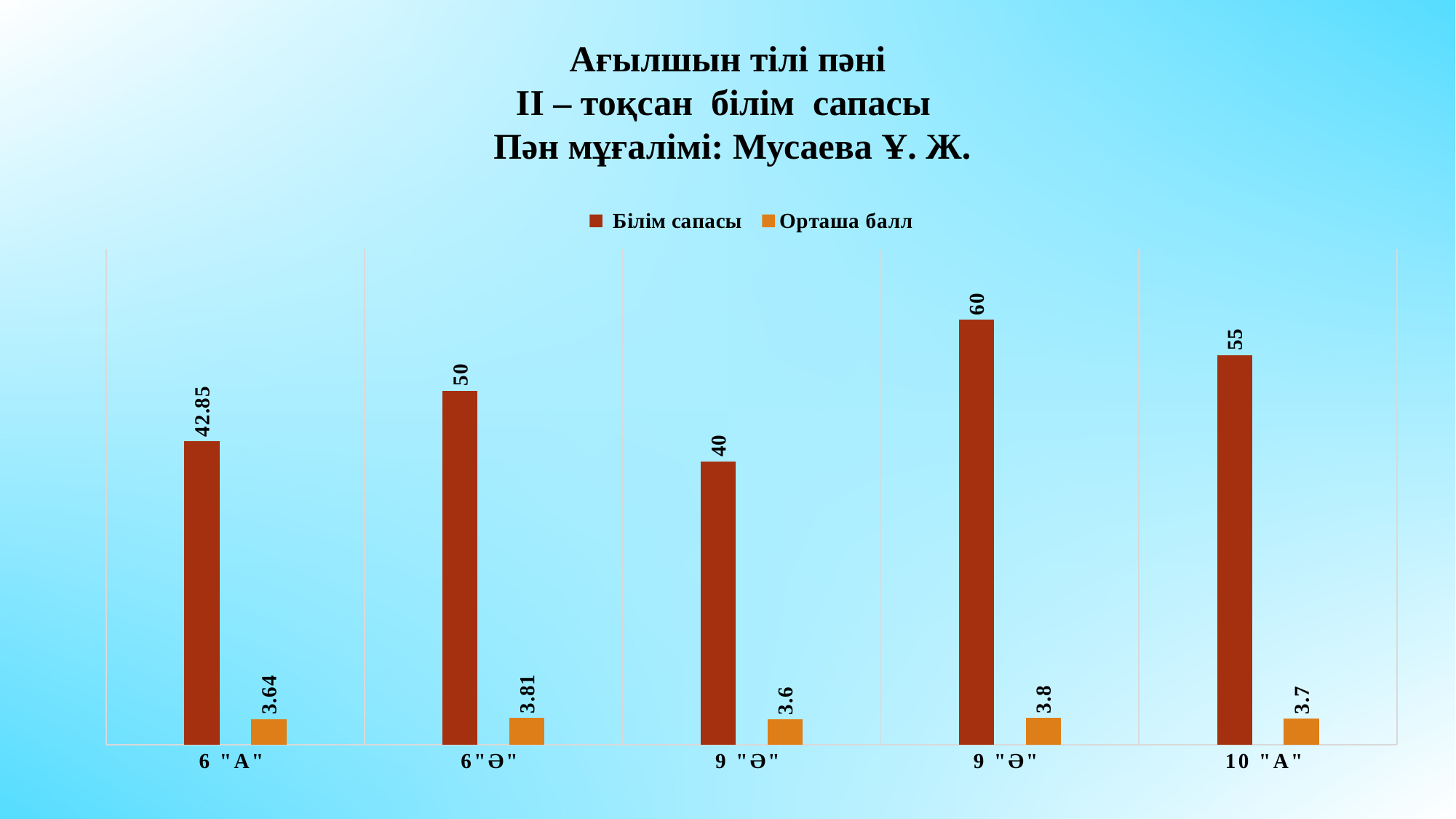
What is the highest Білім сапасы value shown on the chart? 60 What is the lowest Білім сапасы value shown on the chart? 40 What is the difference between the Орташа балл values for 6"Ә" and 6 "А"? 0.17 What is the Орташа балл value for 10 "А"? 3.7 What is the highest Орташа балл value shown on the chart? 3.81 What kind of chart is shown on the slide? Bar chart Which has a higher Орташа балл value, 6"Ә" or 10 "А"? 6"Ә" What is the difference between the Білім сапасы values for 10 "А" and 6 "А"? 12.15 How many categories are shown on the x axis of the chart? 5 How many series does the legend list? 2 What is the Білім сапасы value for 6 "А"? 42.85 What is the Білім сапасы value for 6"Ә"? 50